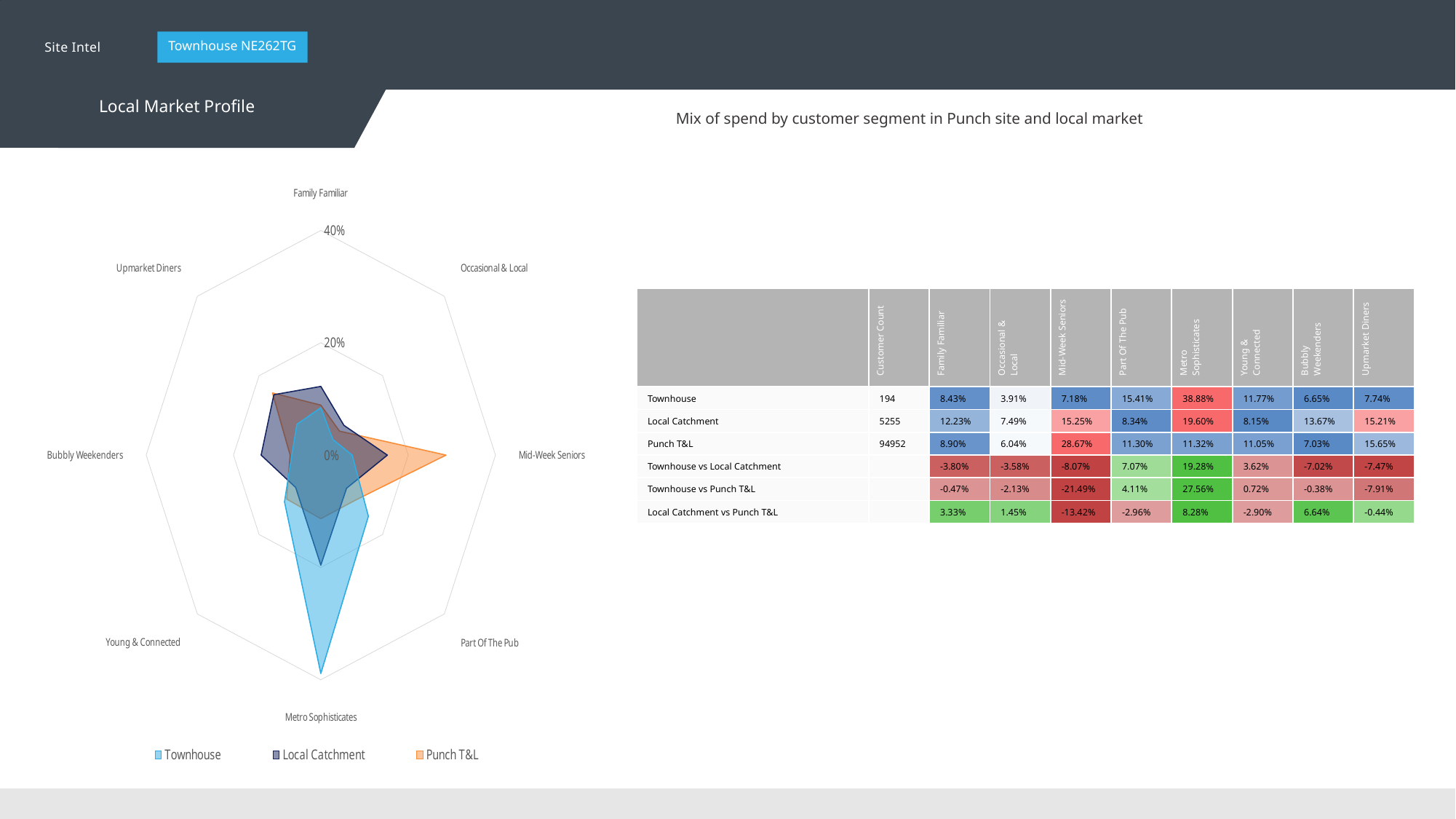
How many series does the legend of the radar chart list? 3 Which customer segment has the highest value for the Punch T&L series on the radar chart? Mid-Week Seniors What is the Townhouse share of spend for Metro Sophisticates, as shown in the table? 38.88% What kind of chart is shown on the left of the slide? Radar chart Is the Local Catchment value for Family Familiar on the radar chart greater or less than 20%? less Is the Townhouse value for Metro Sophisticates on the radar chart greater or less than 20%? greater Which series has the larger value for Mid-Week Seniors, Townhouse or Punch T&L? Punch T&L What is the difference between the Townhouse and Local Catchment values for Metro Sophisticates? 19.28% Which colour represents the Punch T&L series on the radar chart? Orange How many customer segments are plotted on the radar chart? 8 Which customer segment has the highest value for the Townhouse series on the radar chart? Metro Sophisticates Which customer segment has the lowest value for the Townhouse series? Occasional & Local